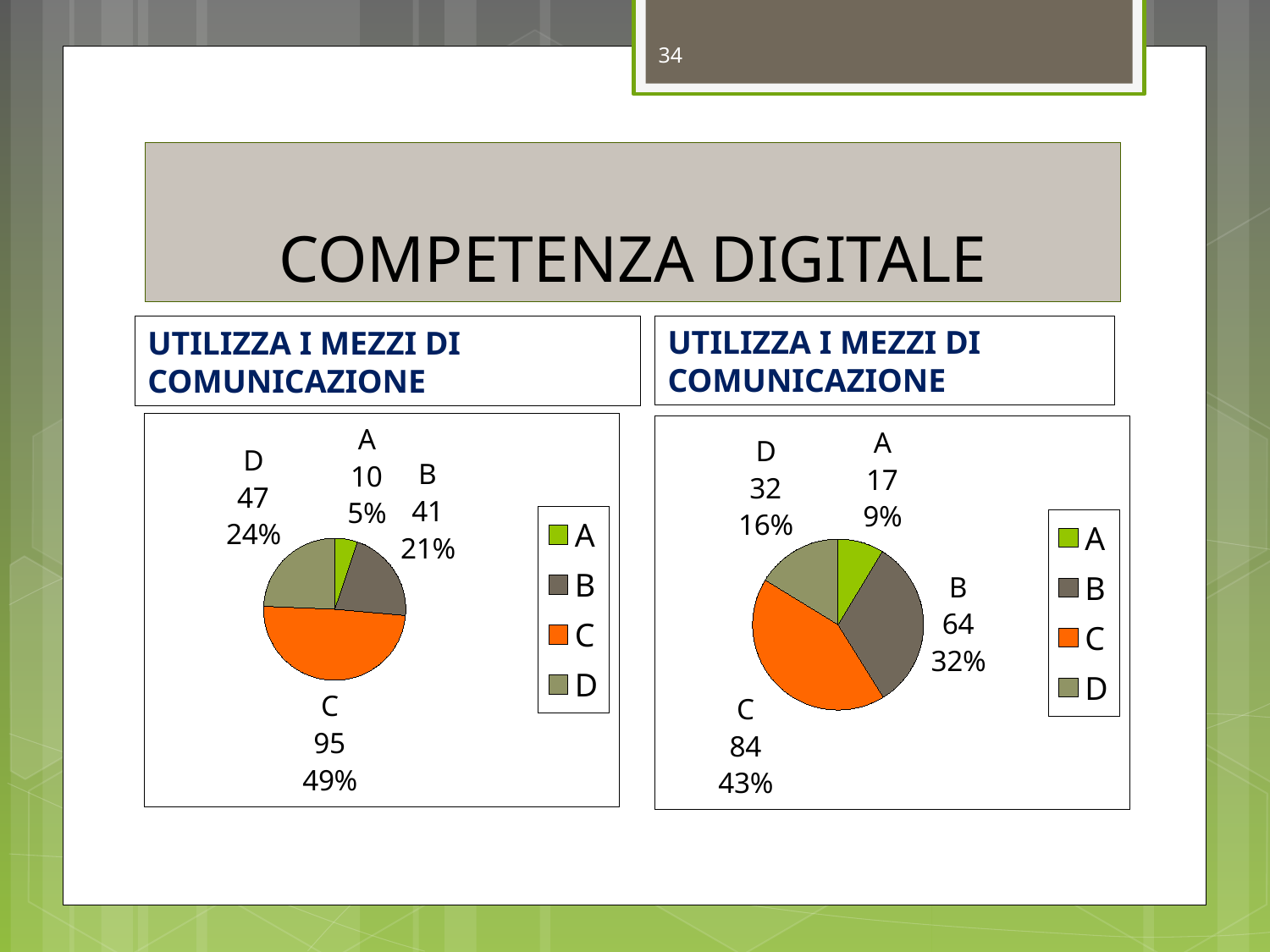
In the left pie chart, what percentage share does category D have? 24% In the left pie chart, what is the difference between the values for C and D? 48 What type of chart is the right chart on the slide? Pie chart In the left pie chart, what is the value for category C? 95 What colour represents category C in the legend of the left pie chart? Orange In the right pie chart, what is the difference between the values for C and A? 67 How many categories does the left pie chart show? 4 In the right pie chart, what percentage share does category B have? 32% In the right pie chart, which category has the largest slice? C In the left pie chart, which category has the smallest slice? A In the right pie chart, which is larger, the value for B or the value for D? B In the right pie chart, what is the value for category A? 17